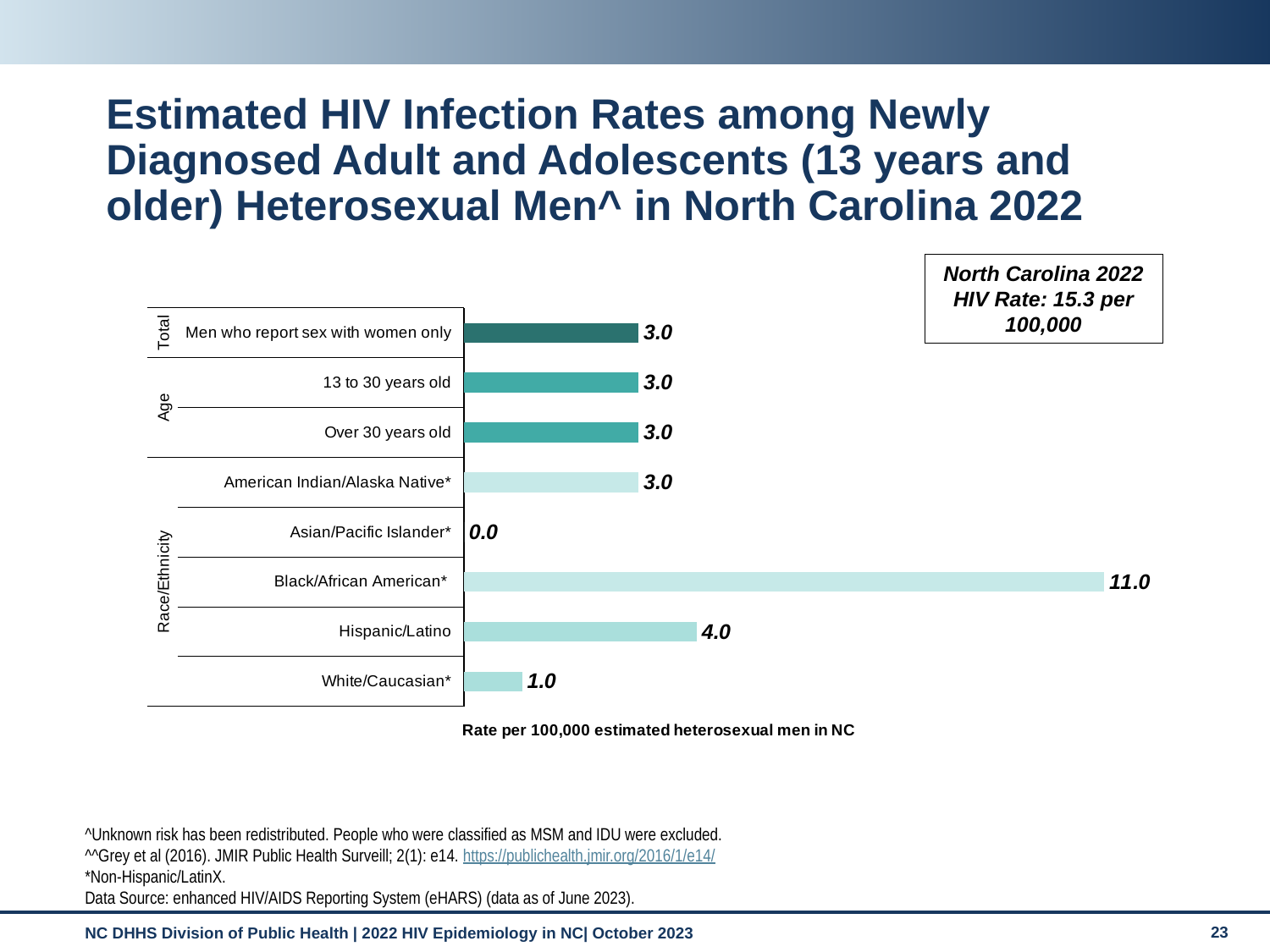
What is the rate for Black/African American* heterosexual men? 11.0 What is the rate for Asian/Pacific Islander* heterosexual men? 0.0 What is the rate for White/Caucasian* heterosexual men? 1.0 What is the difference between the rates for Black/African American* and Hispanic/Latino men? 7.0 What is the overall North Carolina 2022 HIV rate shown in the text box? 15.3 per 100,000 Which is larger, the rate for Hispanic/Latino men or the rate for White/Caucasian* men? Hispanic/Latino What is the rate for Hispanic/Latino heterosexual men? 4.0 Which category has the lowest rate? Asian/Pacific Islander* What is the rate for men who report sex with women only (Total)? 3.0 How many categories are plotted in the chart? 8 Which race/ethnicity category has the highest rate? Black/African American* What kind of chart is shown on the slide? Bar chart